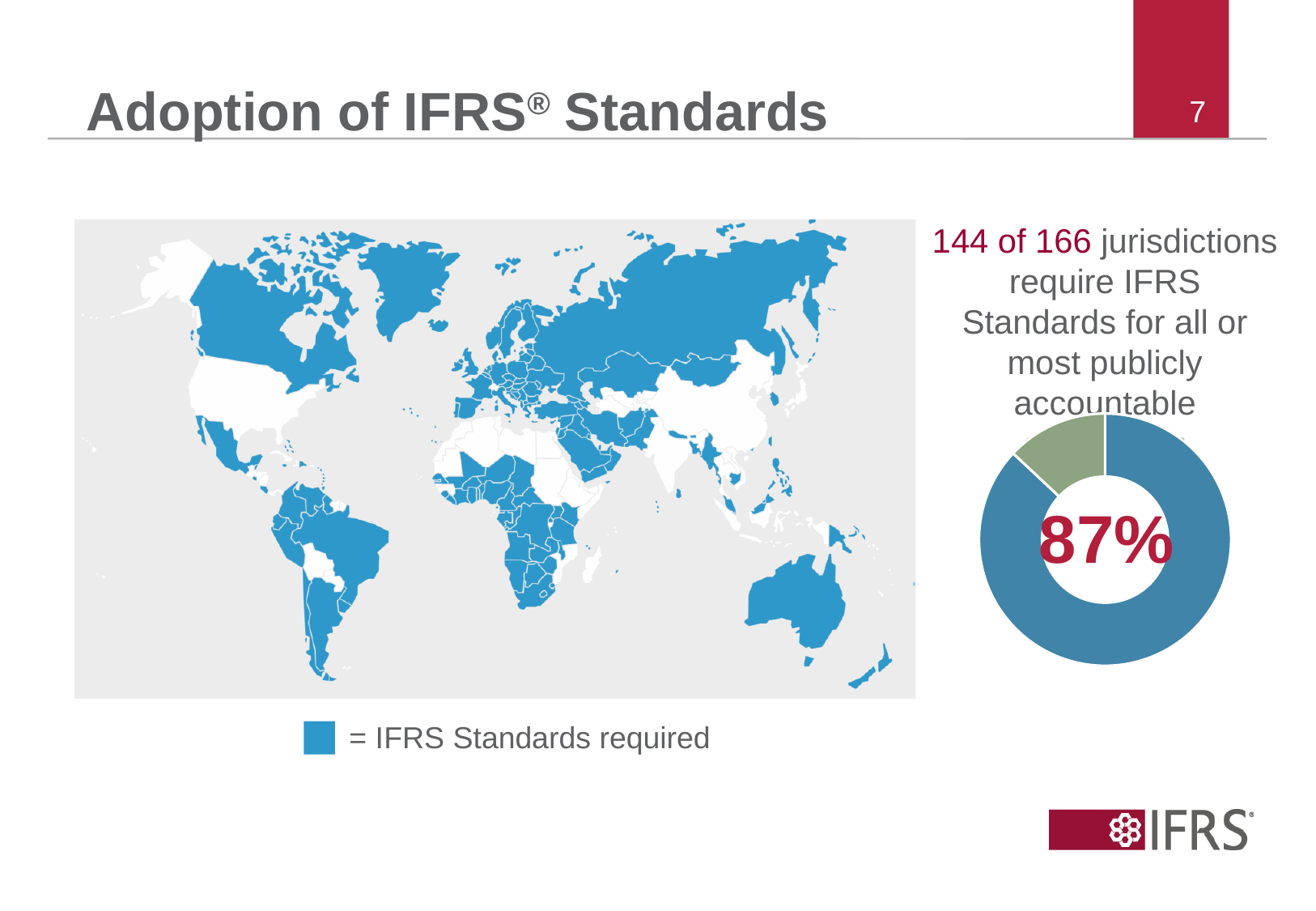
What share of the donut chart does the blue slice represent? 87% Which slice of the donut chart is the smallest? The green slice Is the share shown by the blue slice of the donut chart greater or less than 50%? greater What does the blue colour on the map represent, according to the legend? IFRS Standards required What is the title of the slide containing the donut chart? Adoption of IFRS® Standards Which slice of the donut chart is larger, the blue one or the green one? The blue one How many slices does the donut chart have? 2 What percentage is printed in the centre of the donut chart? 87% What kind of chart is shown on the right of the slide? Donut (pie) chart According to the slide, how many of the 166 jurisdictions require IFRS Standards for all or most publicly accountable entities? 144